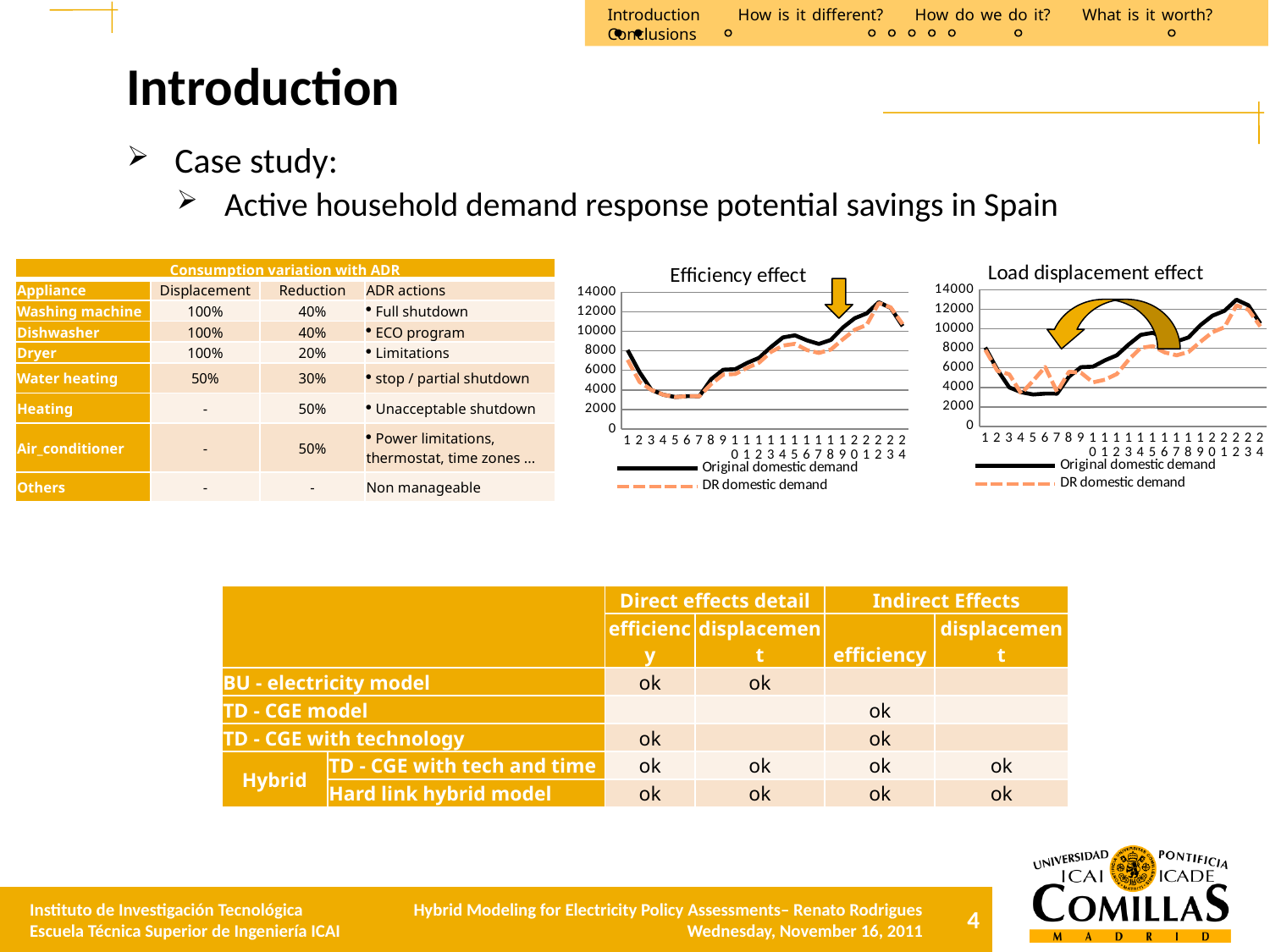
In the "Efficiency effect" chart, is the Original domestic demand value at hour 22 greater or less than 12000? greater In the "Efficiency effect" chart, is the Original domestic demand value at hour 5 greater or less than 4000? less In the "Efficiency effect" chart, at hour 20, which series has the larger value: Original domestic demand or DR domestic demand? Original domestic demand In the "Efficiency effect" chart, which series is drawn with a dashed line? DR domestic demand In the "Load displacement effect" chart, at hour 5, which series has the larger value: Original domestic demand or DR domestic demand? DR domestic demand What kind of chart is the "Efficiency effect" chart? line chart What is the highest tick value shown on the y axis of the "Load displacement effect" chart? 14000 In the "Load displacement effect" chart, is the Original domestic demand value at hour 22 greater or less than 12000? greater In the "Efficiency effect" chart, does the Original domestic demand rise or fall from hour 1 to hour 4? fall How many points along the x axis does the "Efficiency effect" chart plot for each series? 24 How many series does the legend of the "Load displacement effect" chart list? 2